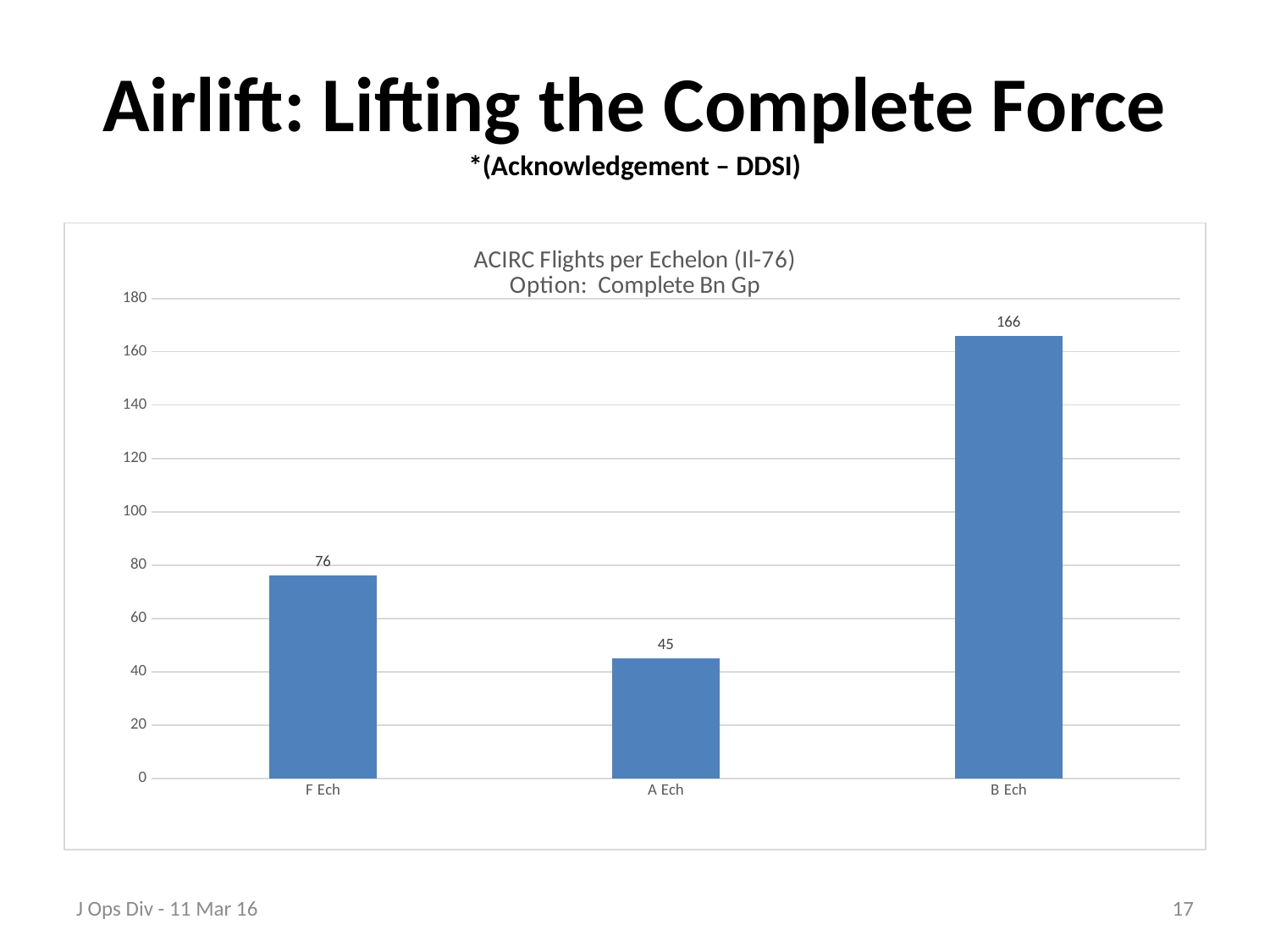
What is the difference between the values for B Ech and F Ech? 90 What is the title of the chart? ACIRC Flights per Echelon (Il-76) Option: Complete Bn Gp What is the value for B Ech? 166 What kind of chart is shown on the slide? bar chart What is the value for A Ech? 45 Is the value for B Ech greater or less than 140? greater Which is larger, the value for F Ech or the value for A Ech? F Ech How many categories are shown on the x axis? 3 What is the difference between the values for F Ech and A Ech? 31 Which echelon has the highest number of flights? B Ech Which echelon has the lowest number of flights? A Ech What is the value for F Ech? 76